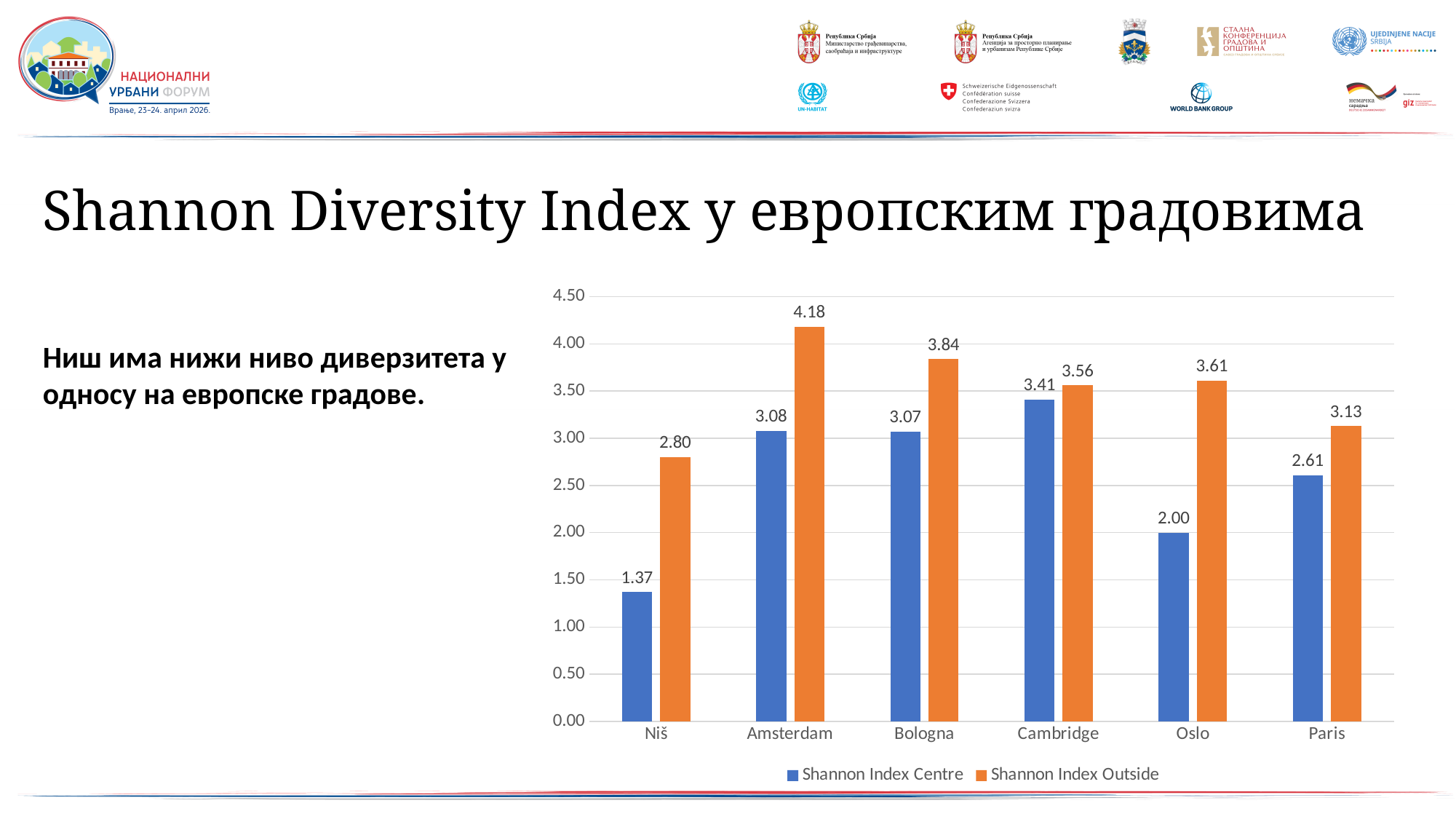
What is the Shannon Index Centre value for Niš? 1.37 What is the Shannon Index Outside value for Amsterdam? 4.18 Which city has the highest Shannon Index Outside value? Amsterdam Is the Shannon Index Centre value for Paris greater or less than 3.00? less How many series does the chart legend list? 2 Which city has the lowest Shannon Index Centre value? Niš What kind of chart is shown on the slide? Bar chart What is the Shannon Index Centre value for Oslo? 2.00 Which is larger for Cambridge: the Shannon Index Centre or the Shannon Index Outside value? Shannon Index Outside What is the difference between the Shannon Index Outside and Shannon Index Centre values for Niš? 1.43 How many cities are shown on the x axis of the chart? 6 What colour are the Shannon Index Outside bars? Orange